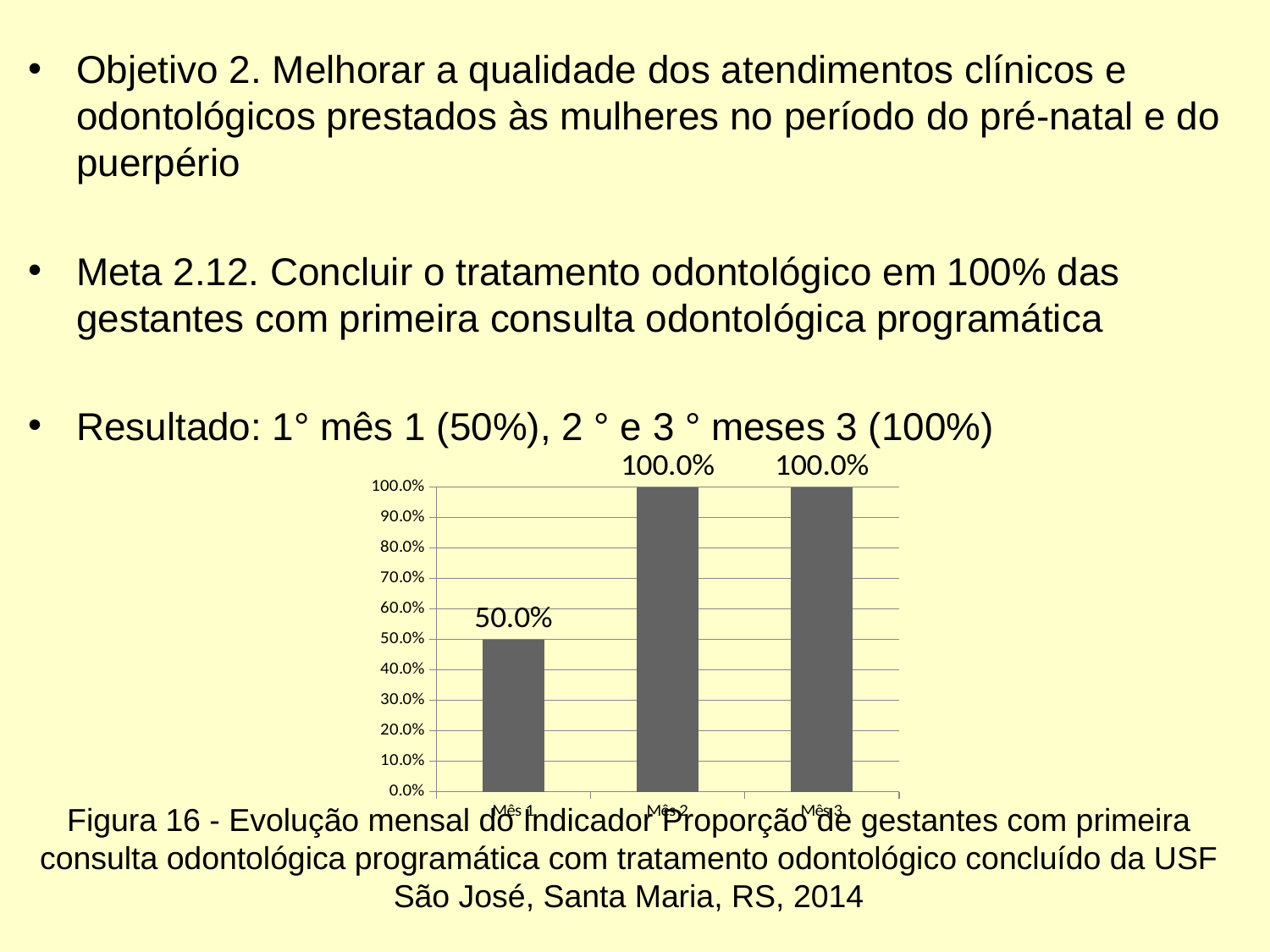
What kind of chart is shown on the slide? bar chart Do the values rise or fall from Mês 1 to Mês 2? rise What is the value for Mês 3? 100.0% What is the highest value shown on the vertical axis? 100.0% What is the difference between the values for Mês 2 and Mês 1? 50.0% What is the value for Mês 1? 50.0% What is the value for Mês 2? 100.0% Is the value for Mês 1 greater or less than 60.0%? less What colour are the bars in the chart? grey Which is larger, the value for Mês 1 or the value for Mês 3? Mês 3 How many bars are plotted in the chart? 3 Which month has the lowest value? Mês 1